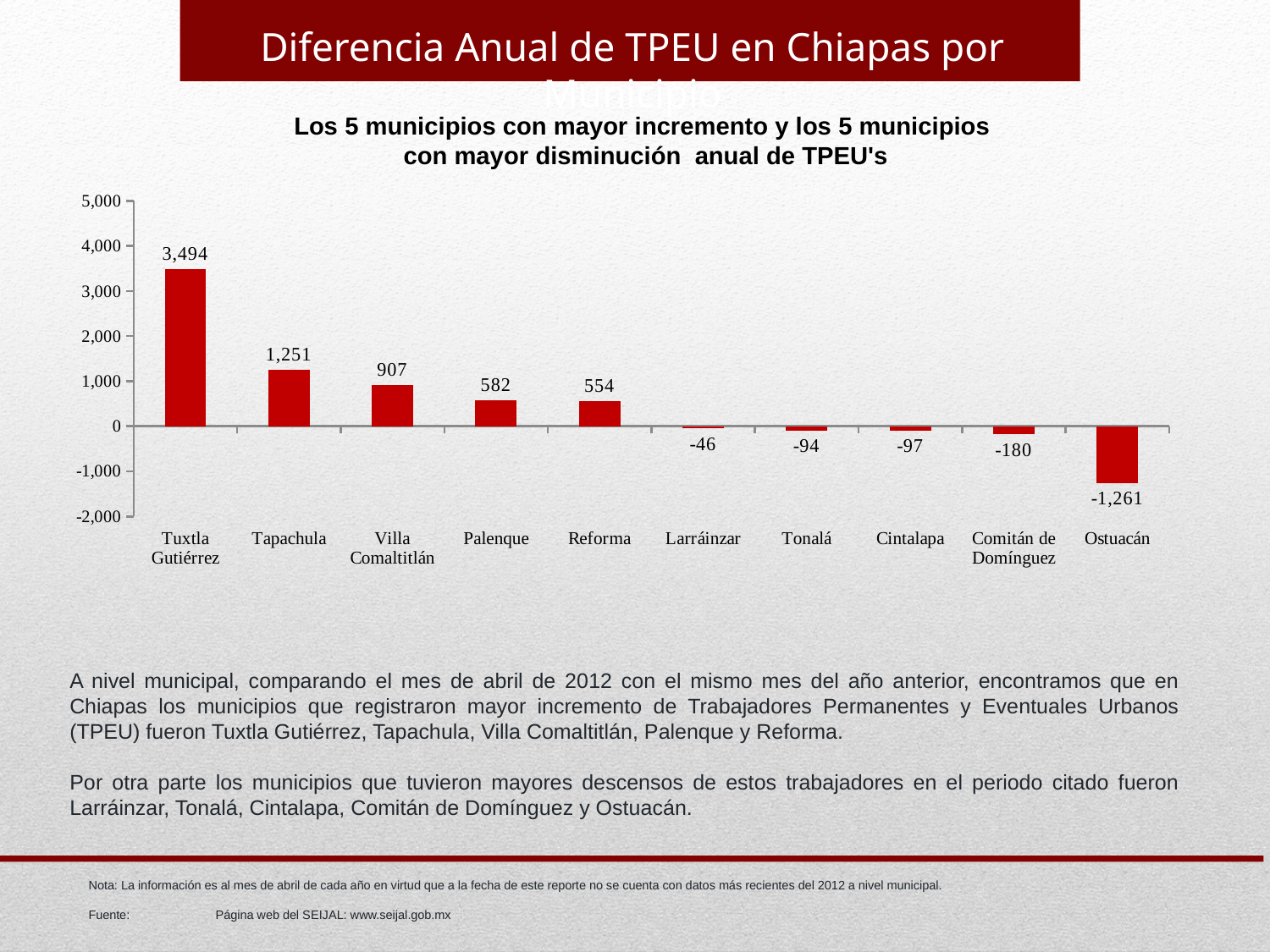
Do the values rise or fall from left to right along the x axis? Fall What is the difference between the values for Tonalá and Cintalapa? 3 What is the difference between the values for Tuxtla Gutiérrez and Tapachula? 2,243 How many municipalities are shown on the chart? 10 What is the value for Ostuacán? -1,261 What is the value for Villa Comaltitlán? 907 Which municipality has the highest value? Tuxtla Gutiérrez What kind of chart is shown on the slide? Bar chart What is the value for Comitán de Domínguez? -180 Which municipality has the lowest value? Ostuacán Which is larger, the value for Palenque or the value for Reforma? Palenque What is the value for Tuxtla Gutiérrez? 3,494